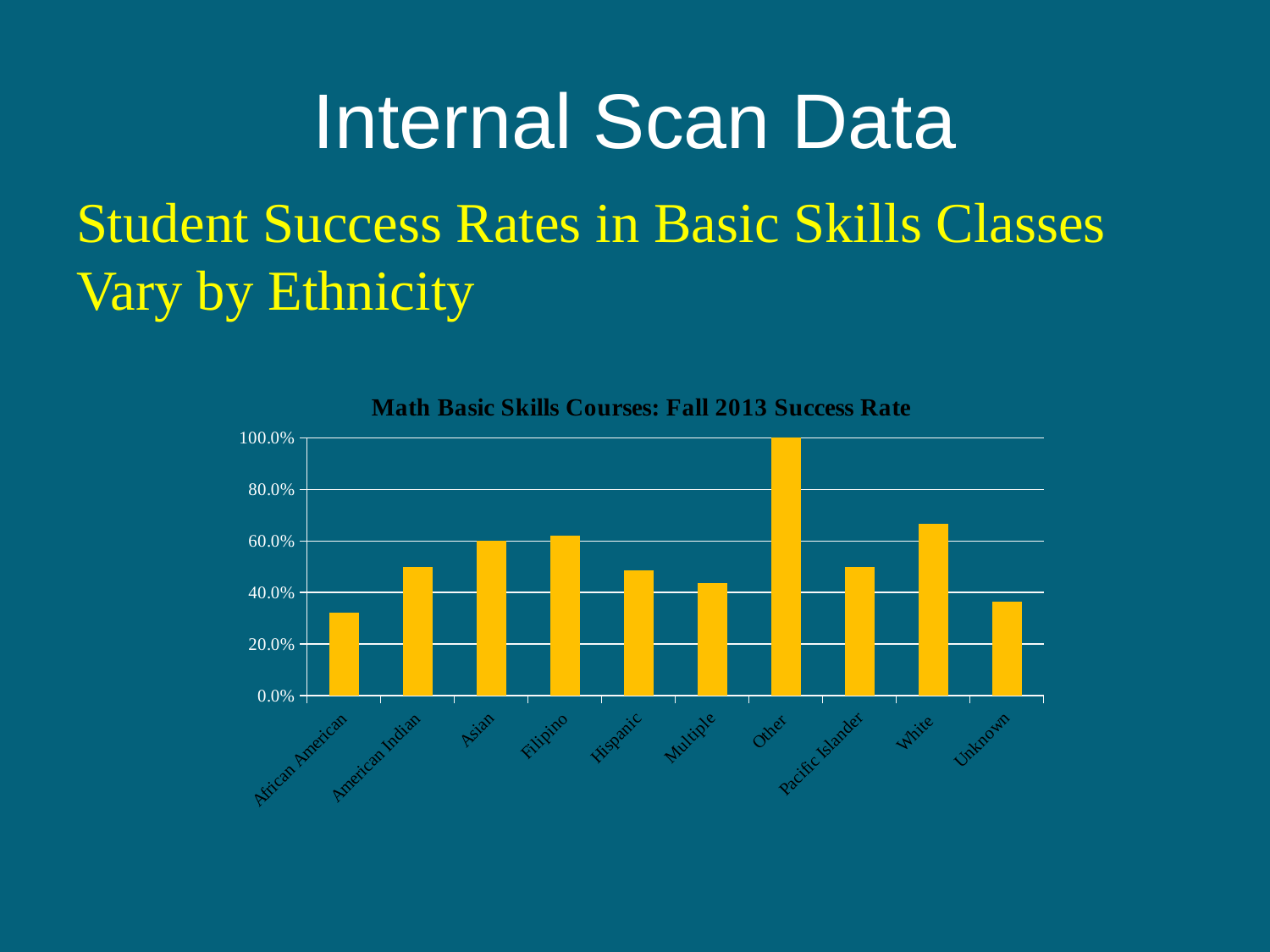
What kind of chart is shown on the slide? Bar chart Is the success rate for Hispanic greater or less than 40.0%? greater Is the success rate for African American greater or less than 40.0%? less Is the success rate for Pacific Islander greater or less than 40.0%? greater How many ethnicity categories are plotted in the chart? 10 What is the success rate for the Other category? 100.0% Which has a higher success rate, White or Asian? White Which has a higher success rate, Hispanic or African American? Hispanic What is the title of the chart? Math Basic Skills Courses: Fall 2013 Success Rate Which category has the highest success rate? Other